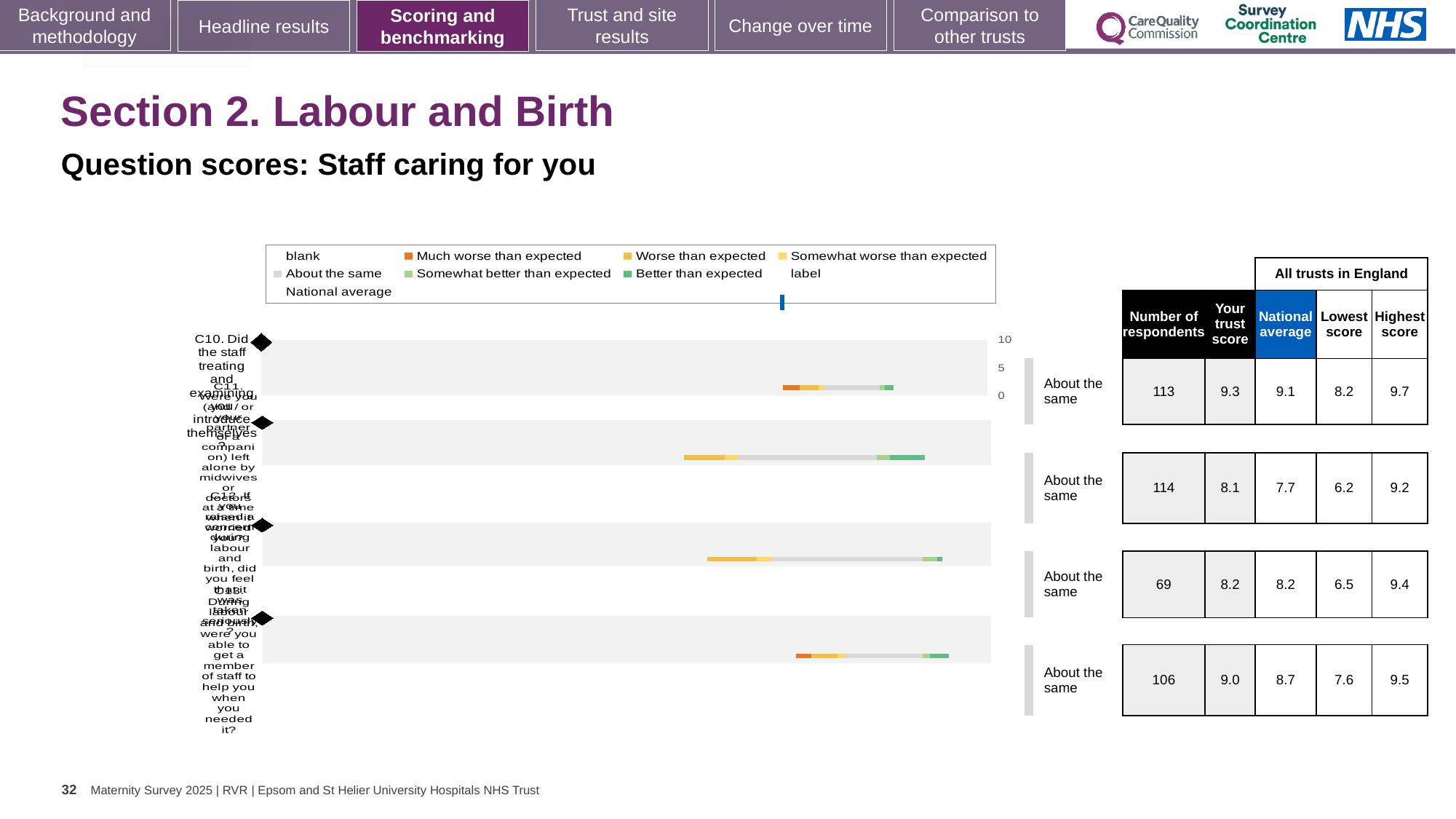
What benchmark category is shown for question C13? About the same Which question has the lowest number of respondents? C12 What is the lowest score among all trusts in England for question C11? 6.2 How many respondents are listed for question C10? 113 What kind of chart is shown on the slide? Bar chart What is the highest score among all trusts in England for question C12? 9.4 Which question has the highest trust score? C10 For question C11, which is larger: the trust score or the national average? Trust score How many questions (C10 to C13) are plotted in the chart? 4 What is the difference between the trust score and the national average for question C10? 0.2 What is the trust score for question C11? 8.1 What is the national average for question C13? 8.7